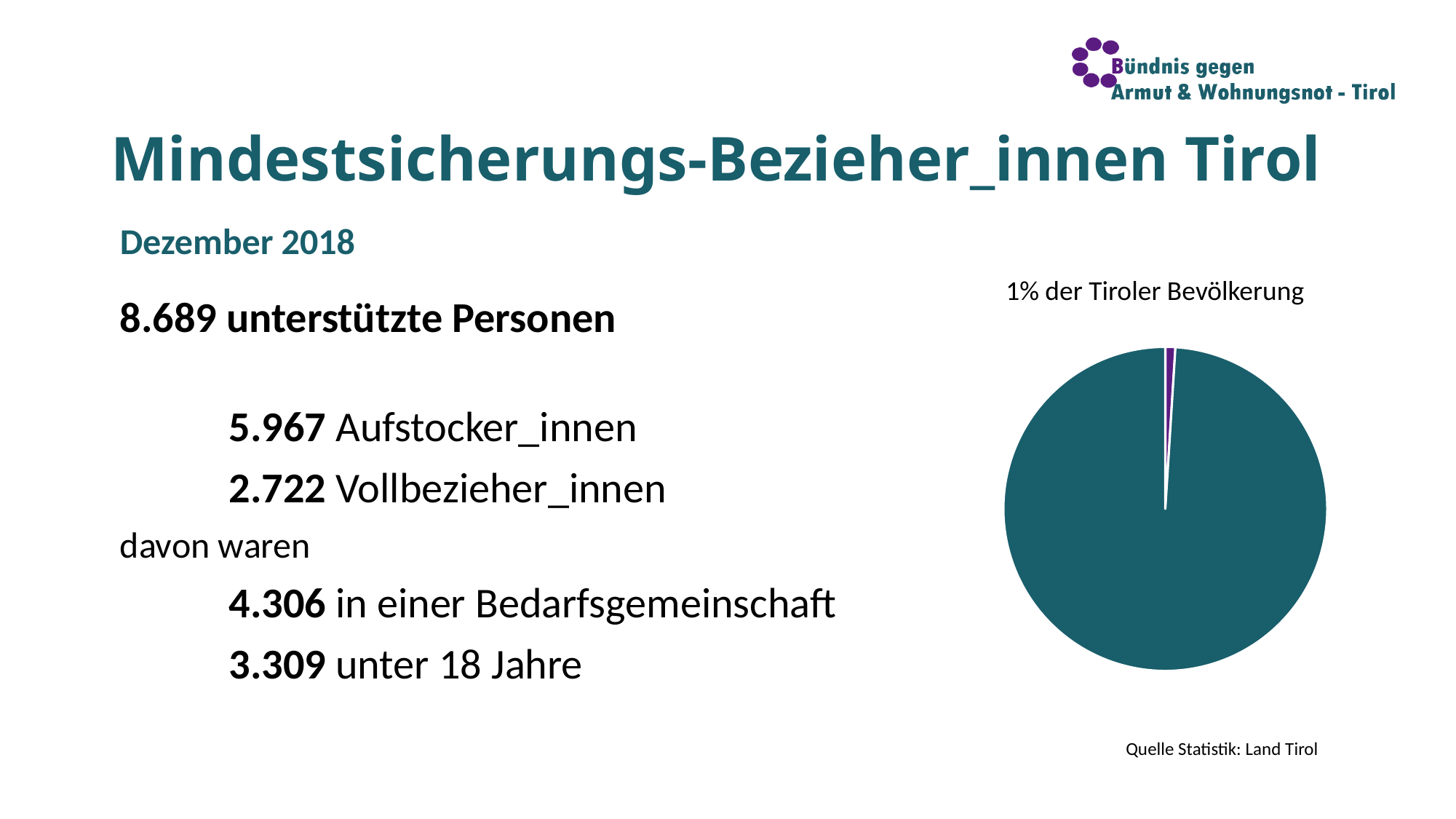
What is the title of the pie chart? 1% der Tiroler Bevölkerung What colour is the small slice of the pie chart? purple Does the pie chart have a legend? no What kind of chart is shown on the slide? pie chart Which slice of the pie chart is larger, the teal one or the purple one? the teal one According to the chart title, what share of the Tyrolean population does the small purple slice represent? 1% How many slices does the pie chart have? 2